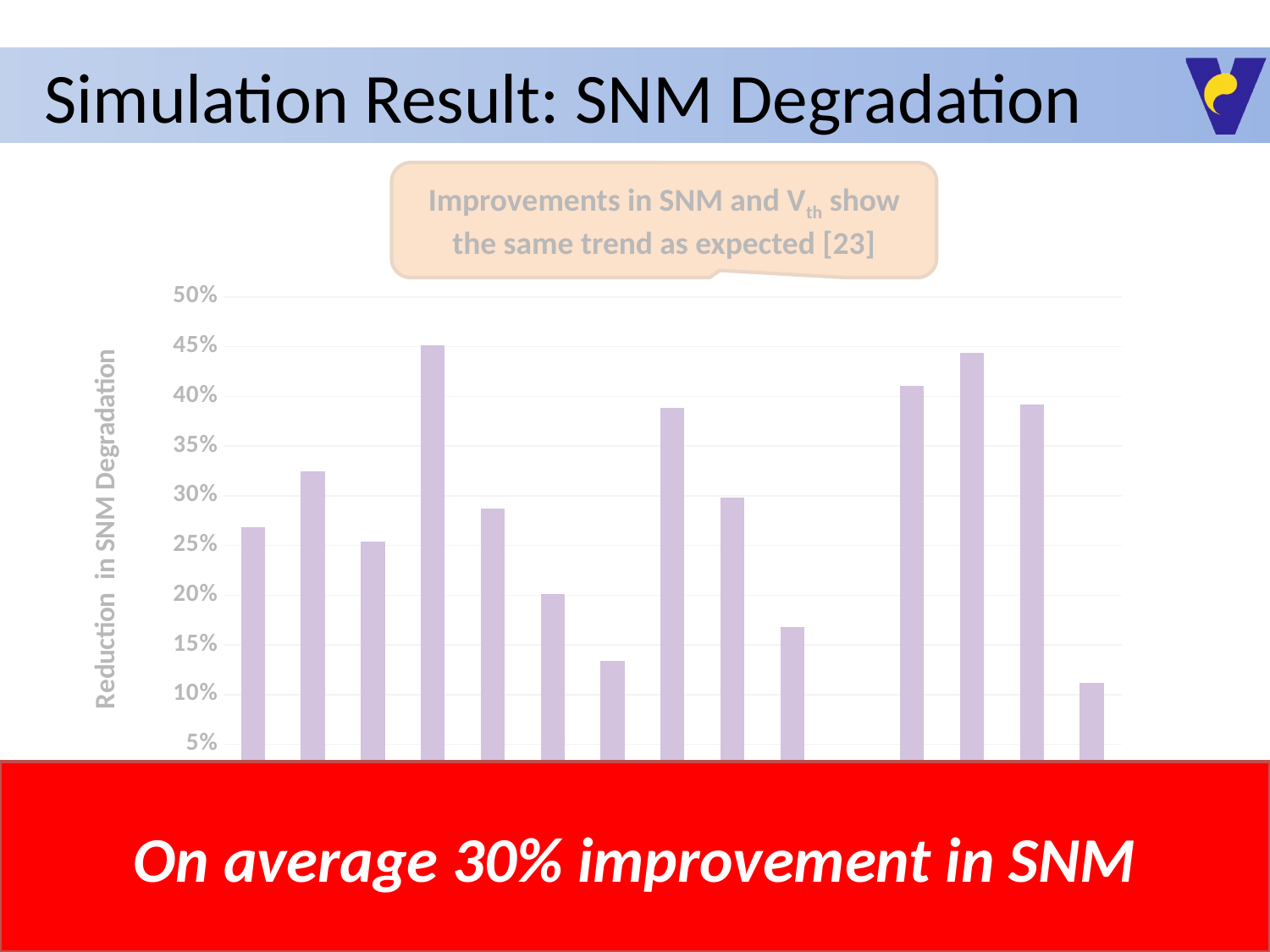
What is the highest tick value shown on the vertical axis? 50% What kind of chart is shown on the slide? bar chart Is the value of the leftmost bar greater or less than 25%? greater Which bar has the lowest value in the chart? the rightmost bar Is the value of the sixth bar from the left greater or less than 25%? less Which is larger, the value of the fourth bar from the left or the value of the fifth bar from the left? the fourth bar Which is larger, the value of the leftmost bar or the value of the rightmost bar? the leftmost bar Is the value of the rightmost bar greater or less than 15%? less What is the label of the vertical axis of the chart? Reduction in SNM Degradation